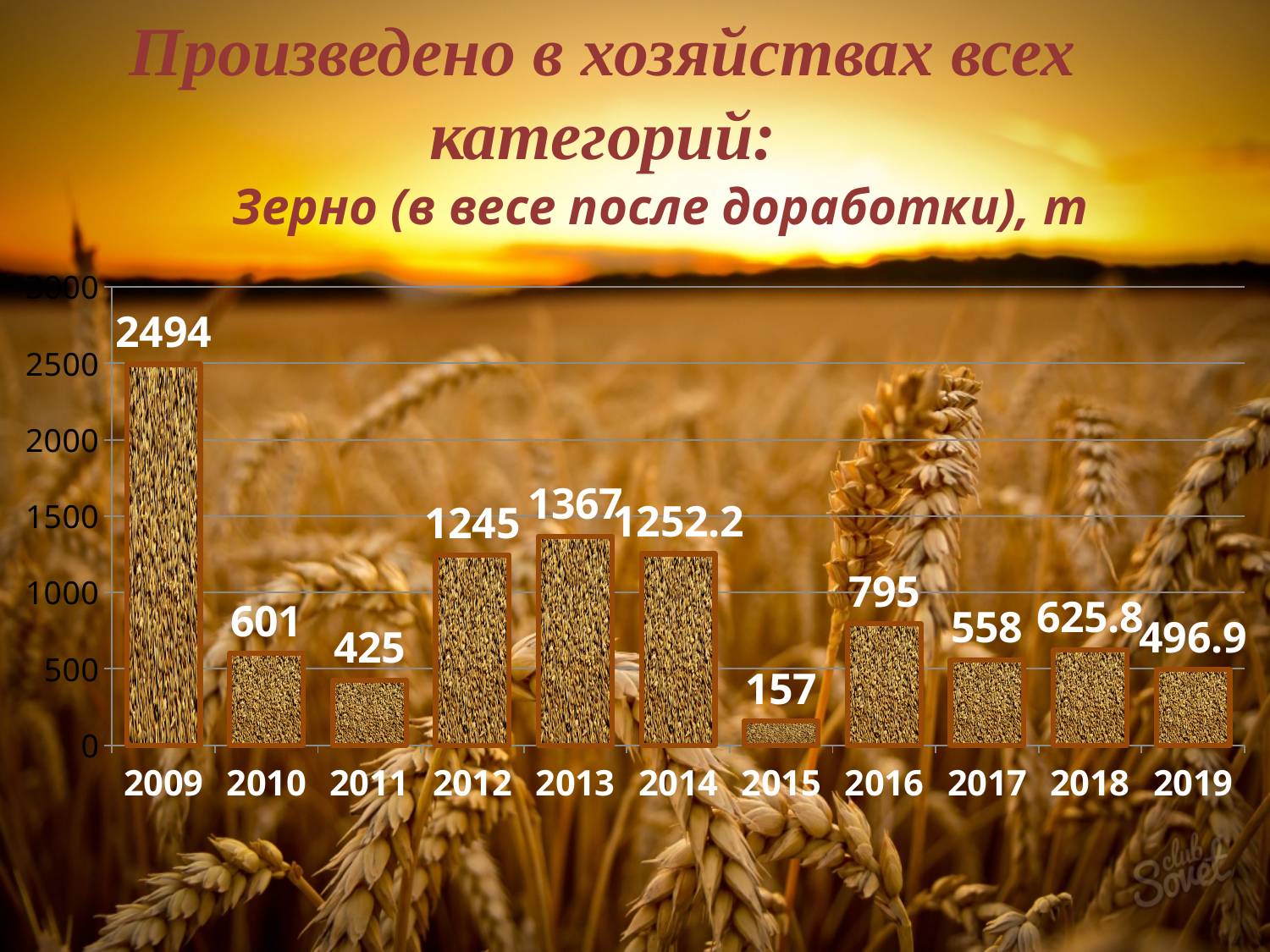
What is the value for 2018? 625.8 What is the value for 2009? 2494 What is the difference between the values for 2013 and 2012? 122 Which is larger, the value for 2010 or the value for 2011? 2010 What is the difference between the values for 2016 and 2017? 237 How many years are shown on the x axis? 11 What type of chart is shown on the slide? bar chart Which year has the lowest value? 2015 What unit is given in the chart subtitle for grain production? т What is the value for 2014? 1252.2 Is the value for 2019 greater or less than 500? less Which year has the highest value? 2009